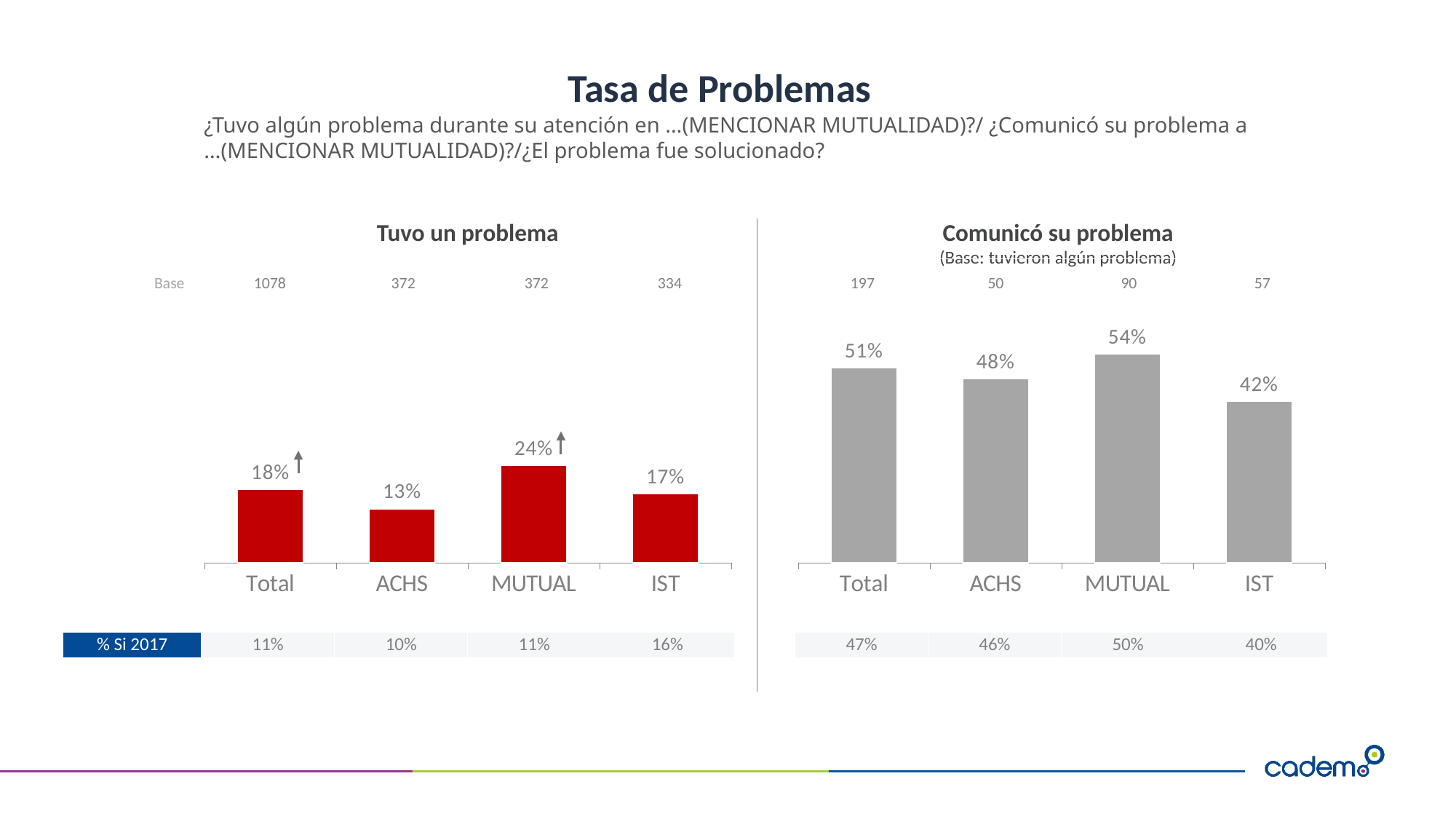
In the 'Tuvo un problema' chart, which category has the highest value? MUTUAL What kind of chart is the 'Tuvo un problema' chart? Bar chart In the 'Comunicó su problema' chart, which category has the highest value? MUTUAL In the 'Comunicó su problema' chart, which is larger, the value for Total or the value for ACHS? Total In the 'Tuvo un problema' chart, what is the difference between the values for MUTUAL and ACHS? 11% In the 'Tuvo un problema' chart, which category has the lowest value? ACHS In the 'Comunicó su problema' chart, what is the value for IST? 42% In the 'Tuvo un problema' chart, what is the value for ACHS? 13% In the 'Comunicó su problema' chart, which category has the lowest value? IST In the 'Tuvo un problema' chart, what is the value for MUTUAL? 24% In the 'Comunicó su problema' chart, what is the value for Total? 51% How many categories are shown in the 'Comunicó su problema' chart? 4